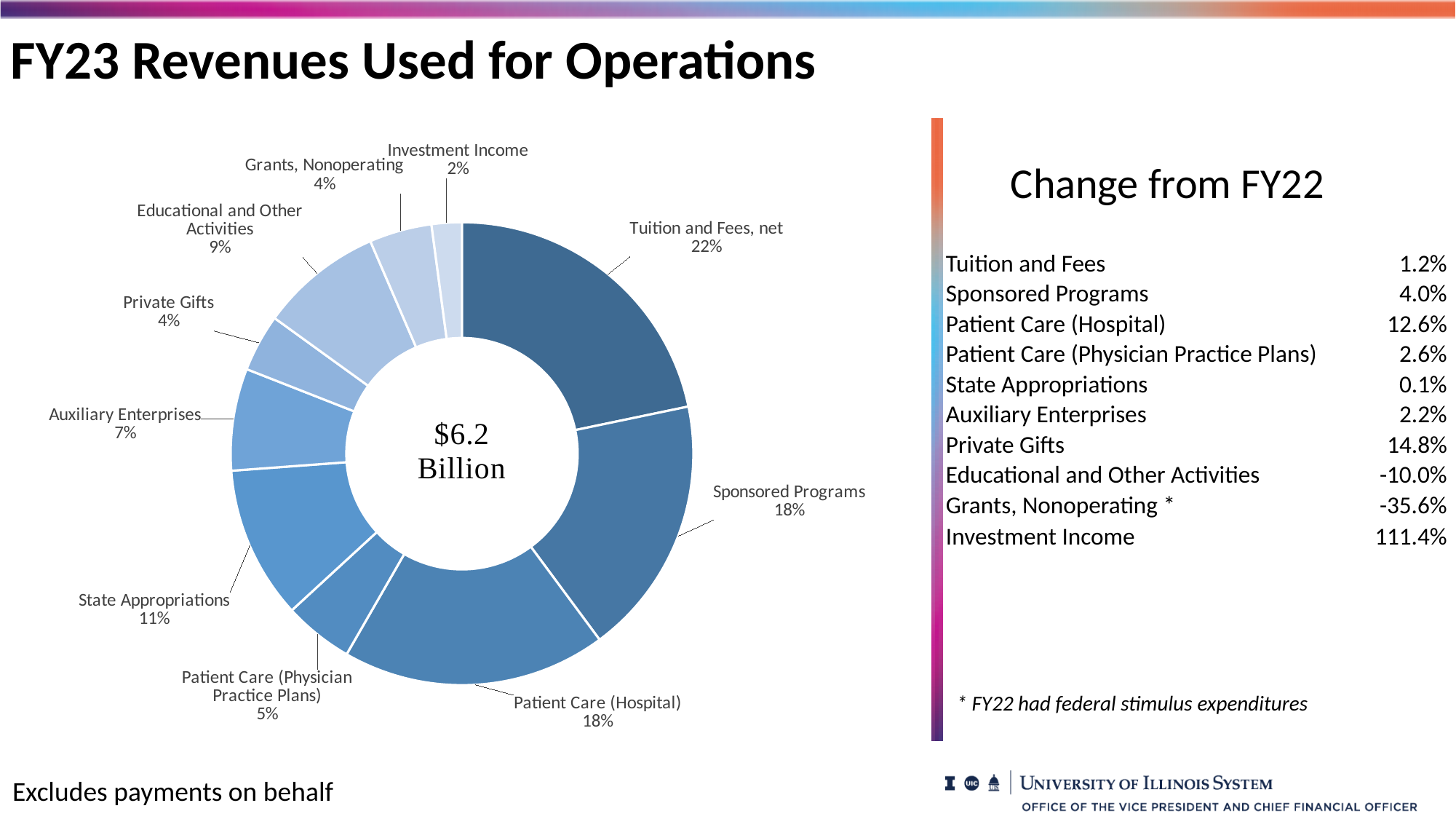
Which category has the largest slice of the pie? Tuition and Fees, net What type of chart is used to show FY23 revenues used for operations? Doughnut chart What is the share for Patient Care (Physician Practice Plans)? 5% What is the difference in percentage points between Tuition and Fees, net and Sponsored Programs? 4 Which is larger: the share for Auxiliary Enterprises or the share for Private Gifts? Auxiliary Enterprises What total amount is shown in the center of the pie chart? $6.2 Billion What share of FY23 revenues used for operations comes from Tuition and Fees, net? 22% Which category has the smallest slice of the pie? Investment Income What is the share for Educational and Other Activities? 9% What percentage of the pie is State Appropriations? 11% How many categories are shown in the pie chart? 10 What is the combined share of Grants, Nonoperating and Investment Income? 6%